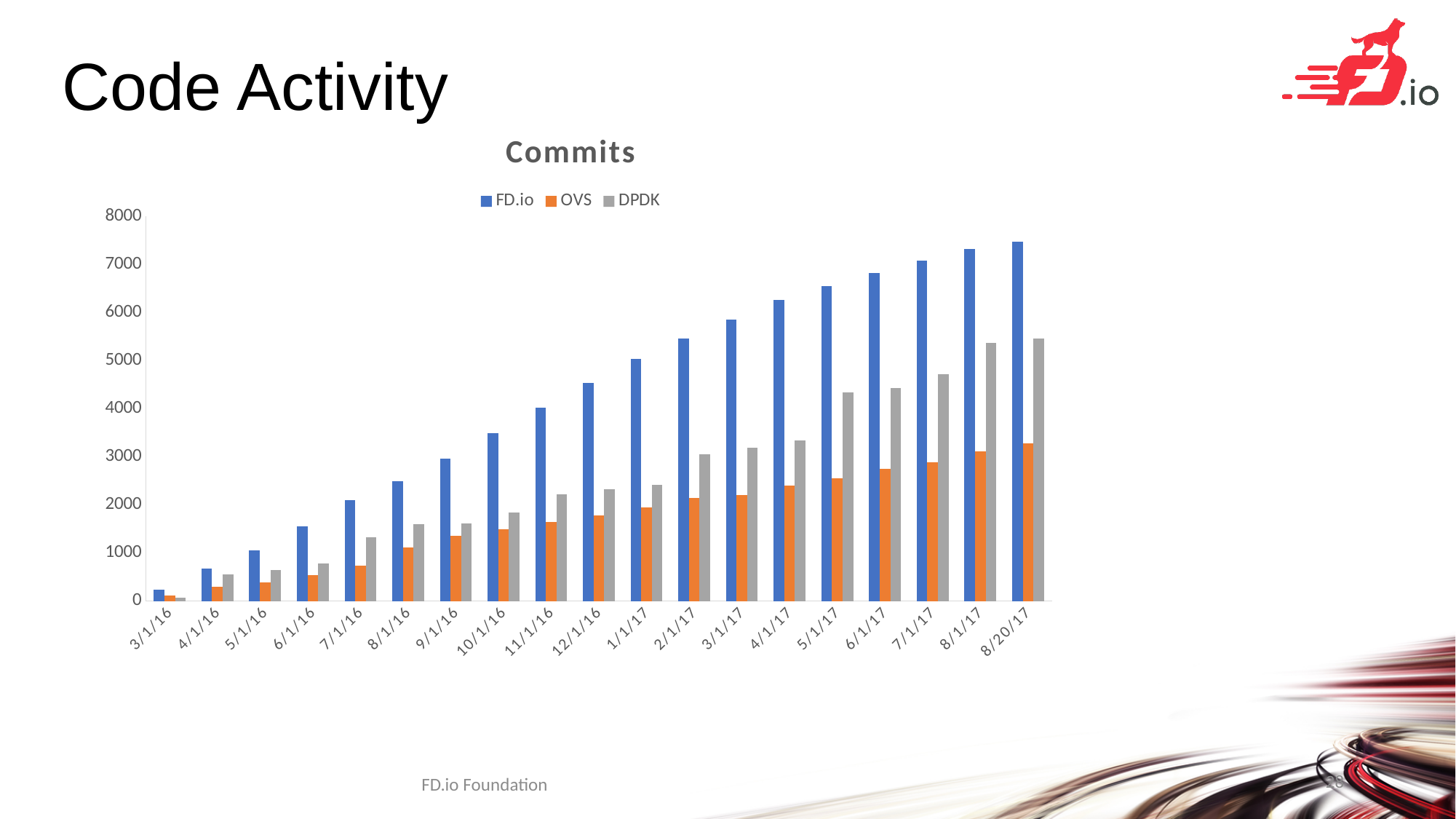
What is the title of the chart? Commits On which date is the FD.io value highest? 8/20/17 What type of chart is shown on the slide? bar chart Which is larger at 8/1/17, the DPDK value or the OVS value? DPDK Do the FD.io values rise or fall from 3/1/16 to 8/20/17? rise Is the FD.io value for 3/1/16 greater or less than 1000? less How many series does the legend list? 3 How many dates are shown along the x axis? 19 Is the FD.io value for 8/20/17 greater or less than 7000? greater Which series is shown in orange? OVS Is the DPDK value for 5/1/17 greater or less than 4000? greater